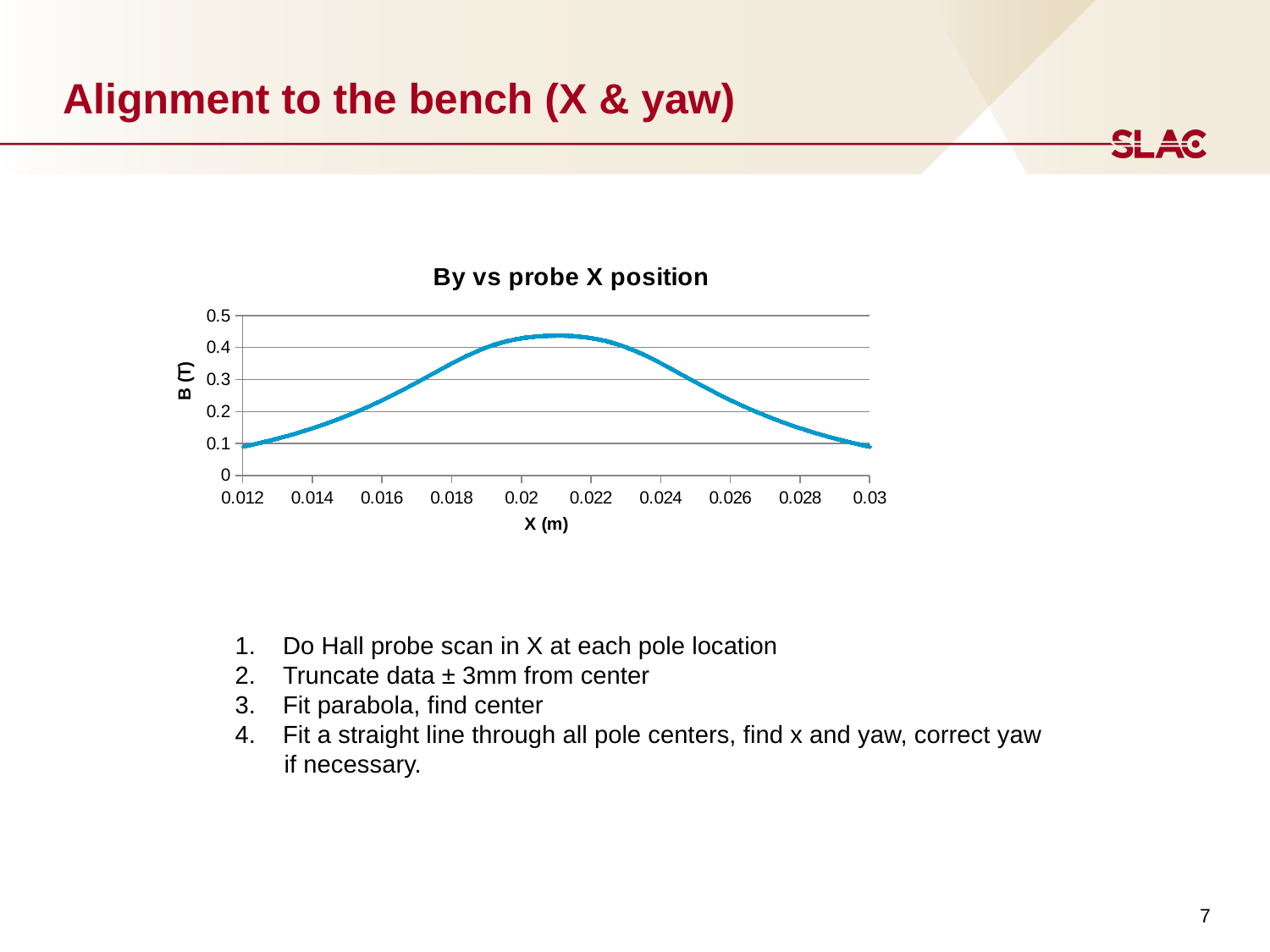
Is the value of B at X = 0.018 m greater or less than 0.3? greater What is the label of the vertical axis of the chart? B (T) Which is larger, the value of B at X = 0.014 m or at X = 0.022 m? X = 0.022 m What kind of chart is shown on the slide? line chart What is the title of the chart? By vs probe X position Is the value of B at X = 0.024 m greater or less than 0.3? greater How does B change as X increases from 0.012 m to 0.03 m? rises then falls Is the maximum value of B on the curve greater or less than 0.5? less Which is larger, the value of B at X = 0.02 m or at X = 0.028 m? X = 0.02 m